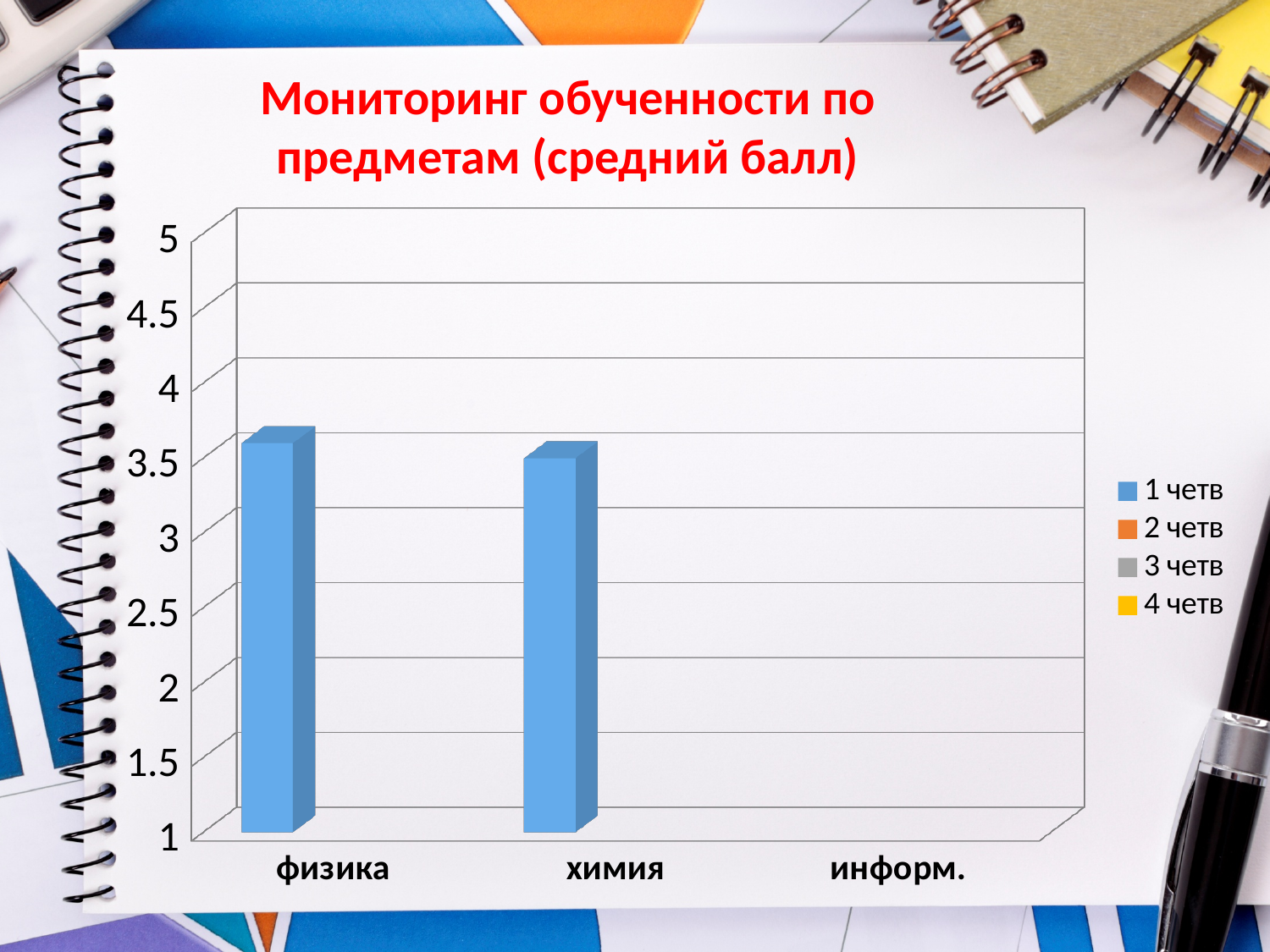
Which colour represents the series "1 четв" in the legend? blue Which has the higher value for 1 четв, физика or химия? физика Is the value for химия (1 четв) greater or less than 3? greater How many series does the chart's legend list? 4 Is the value for физика (1 четв) greater or less than 3? greater Which category on the x axis has no bar plotted? информ. What is the title of the chart? Мониторинг обученности по предметам (средний балл) What kind of chart is shown on the slide? bar chart Which category has the highest bar in the chart? физика How many categories are shown on the x axis of the chart? 3 Is the value for физика (1 четв) greater or less than 4? less